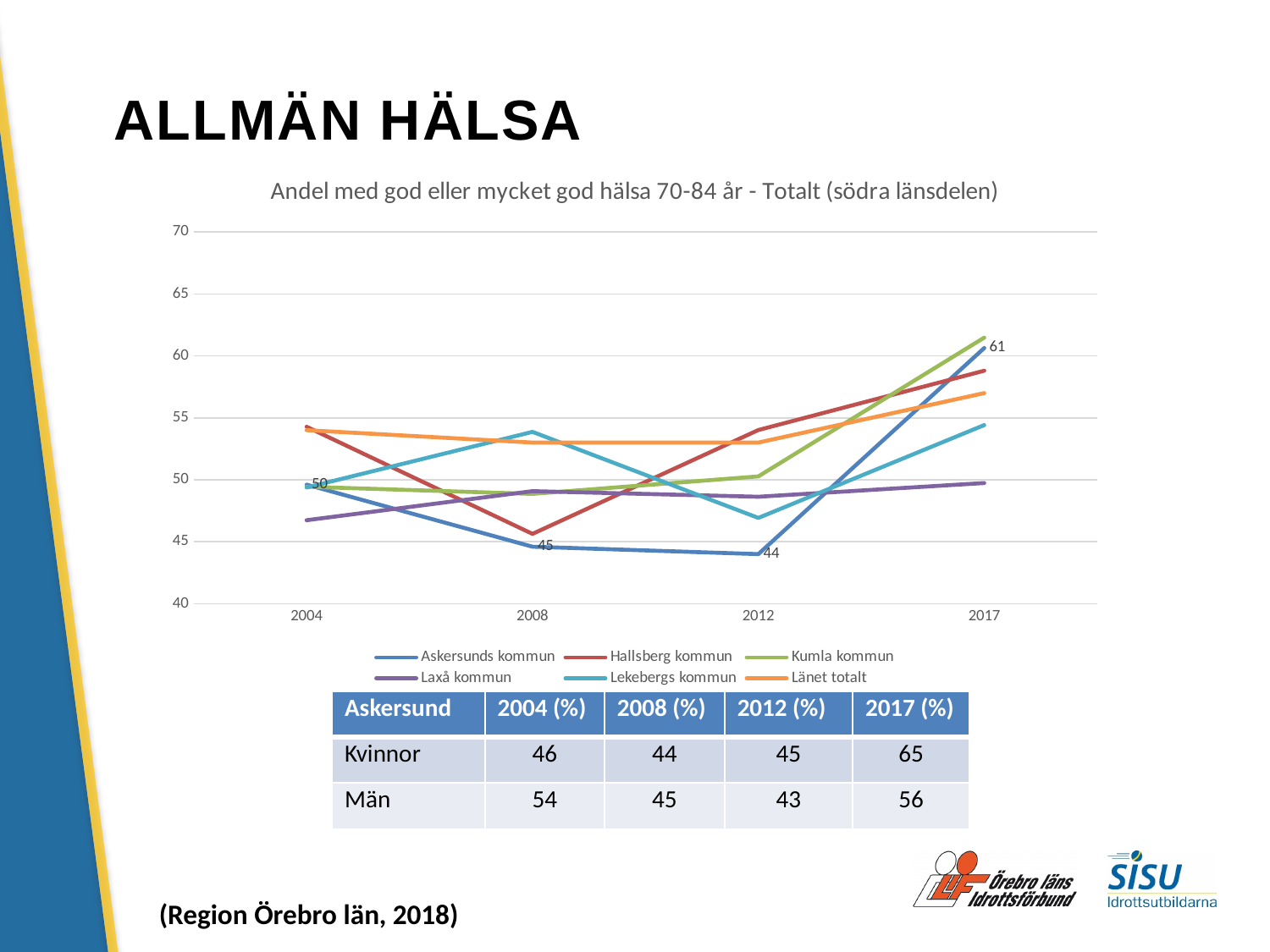
What type of chart is shown on the slide? line chart In which year is the value for Askersunds kommun lowest? 2012 What is the difference between the Askersunds kommun values for 2017 and 2012? 17 What is the title of the chart? Andel med god eller mycket god hälsa 70-84 år - Totalt (södra länsdelen) How many series does the chart legend list? 6 What is the value for Askersunds kommun in 2012? 44 Does the Askersunds kommun line rise or fall between 2012 and 2017? rise What is the value for Askersunds kommun in 2004? 50 Is the value for Länet totalt in 2004 greater or less than 50? greater What is the value for Askersunds kommun in 2017? 61 Is the value for Laxå kommun in 2004 greater or less than 50? less How many years are shown on the x axis of the chart? 4